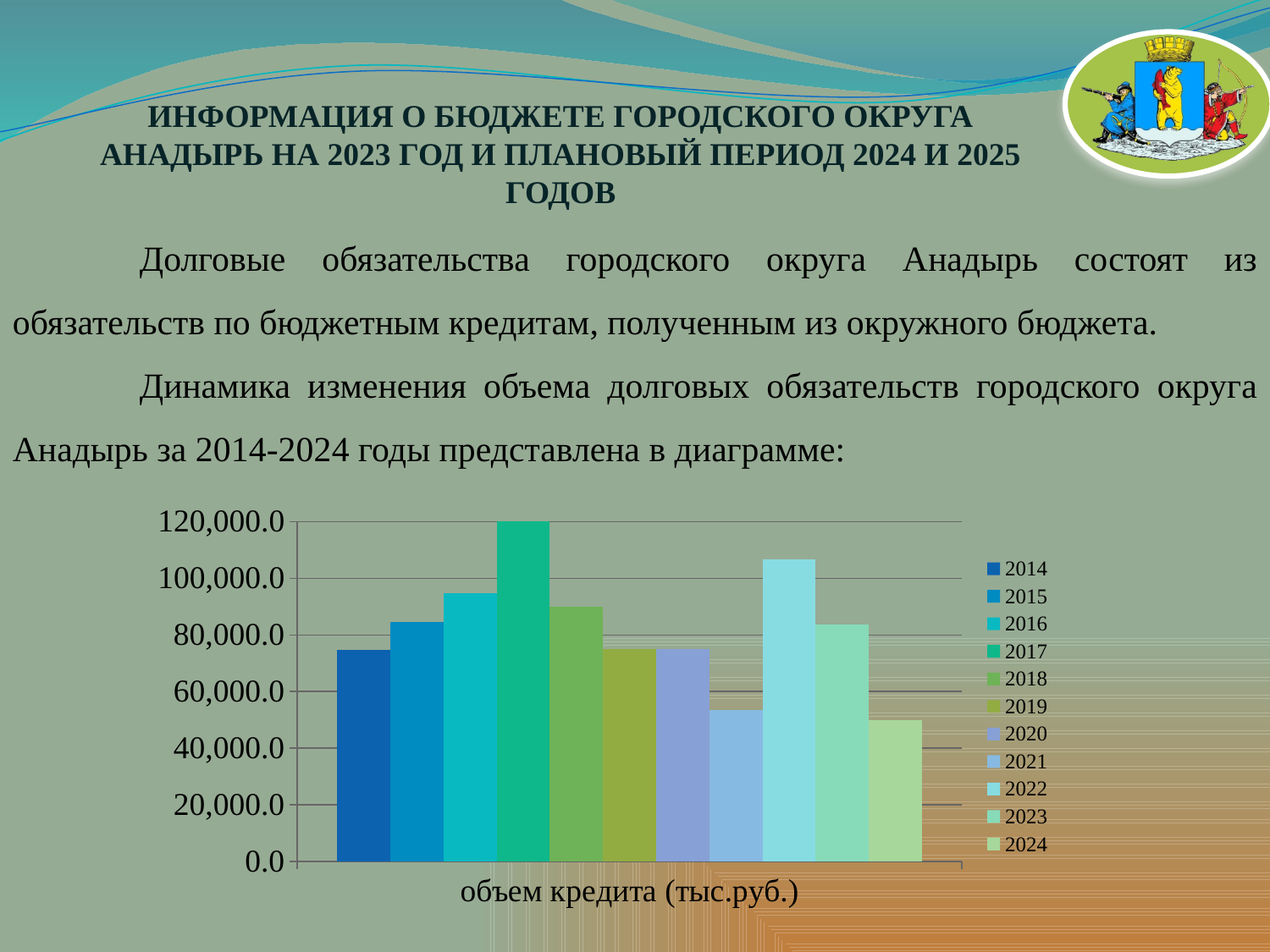
Which year has the highest value in the chart? 2017 Is the value for 2024 greater or less than 60,000.0? less Which is larger, the value for 2022 or the value for 2023? 2022 Which is larger, the value for 2015 or the value for 2021? 2015 Is the value for 2022 greater or less than 100,000.0? greater Is the value for 2021 greater or less than 60,000.0? less What is the value for 2017? 120,000.0 What is the label shown under the x axis of the chart? объем кредита (тыс.руб.) How many series does the legend list? 11 What kind of chart is shown on the slide? bar chart